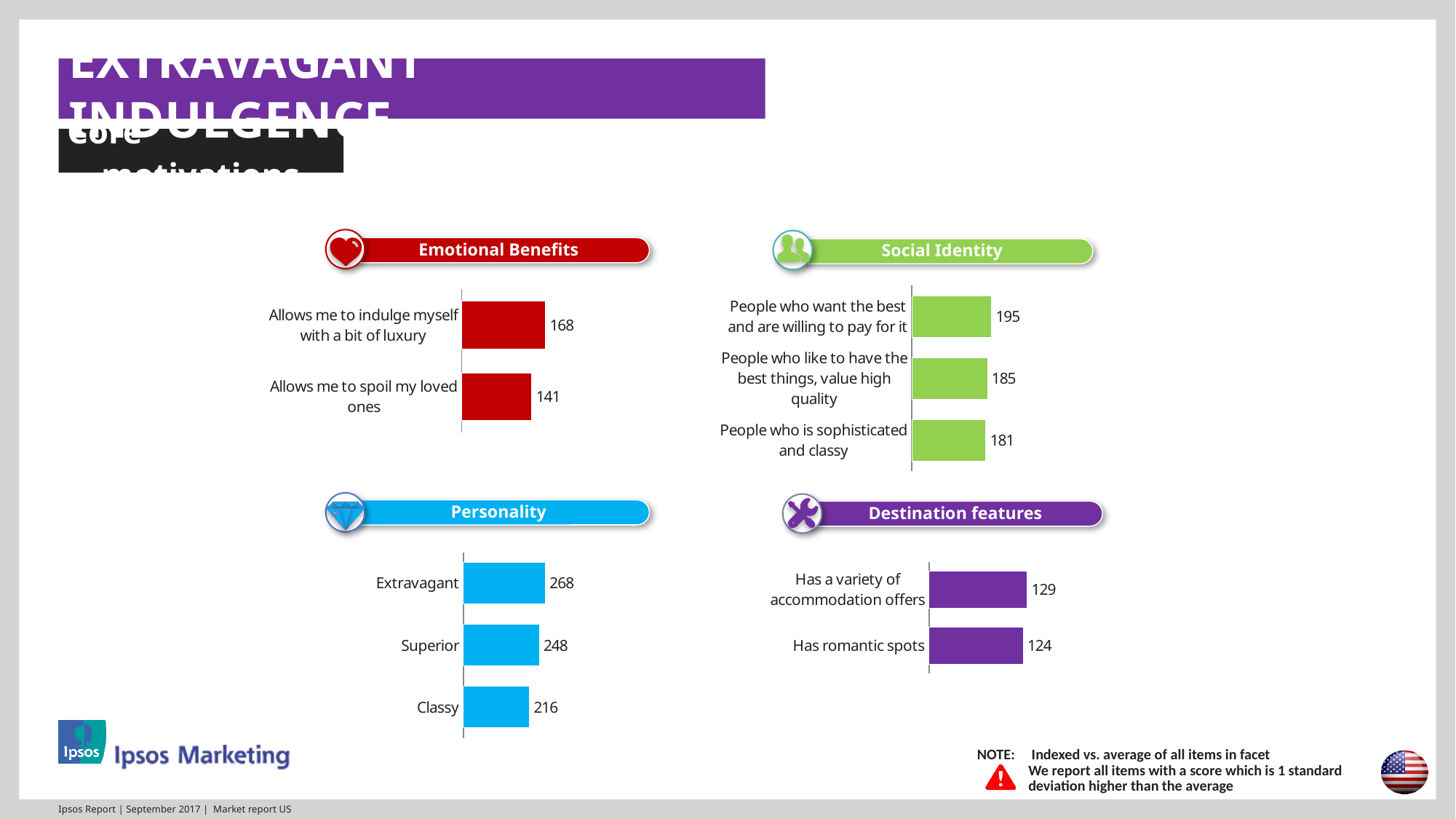
In the Destination features chart, what is the value for "Has romantic spots"? 124 In the Emotional Benefits chart, what is the value for "Allows me to indulge myself with a bit of luxury"? 168 In the Emotional Benefits chart, what is the difference between the two bars? 27 What kind of chart is the Personality chart? Bar chart In the Personality chart, which category has the lowest value? Classy In the Social Identity chart, what is the value for "People who is sophisticated and classy"? 181 In the Personality chart, what is the value for Superior? 248 In the Personality chart, what is the difference between Extravagant and Classy? 52 In the Social Identity chart, which category has the highest value? People who want the best and are willing to pay for it What colour are the bars in the Social Identity chart? Green In the Destination features chart, which is larger: "Has a variety of accommodation offers" or "Has romantic spots"? Has a variety of accommodation offers How many categories are shown in the Social Identity chart? 3